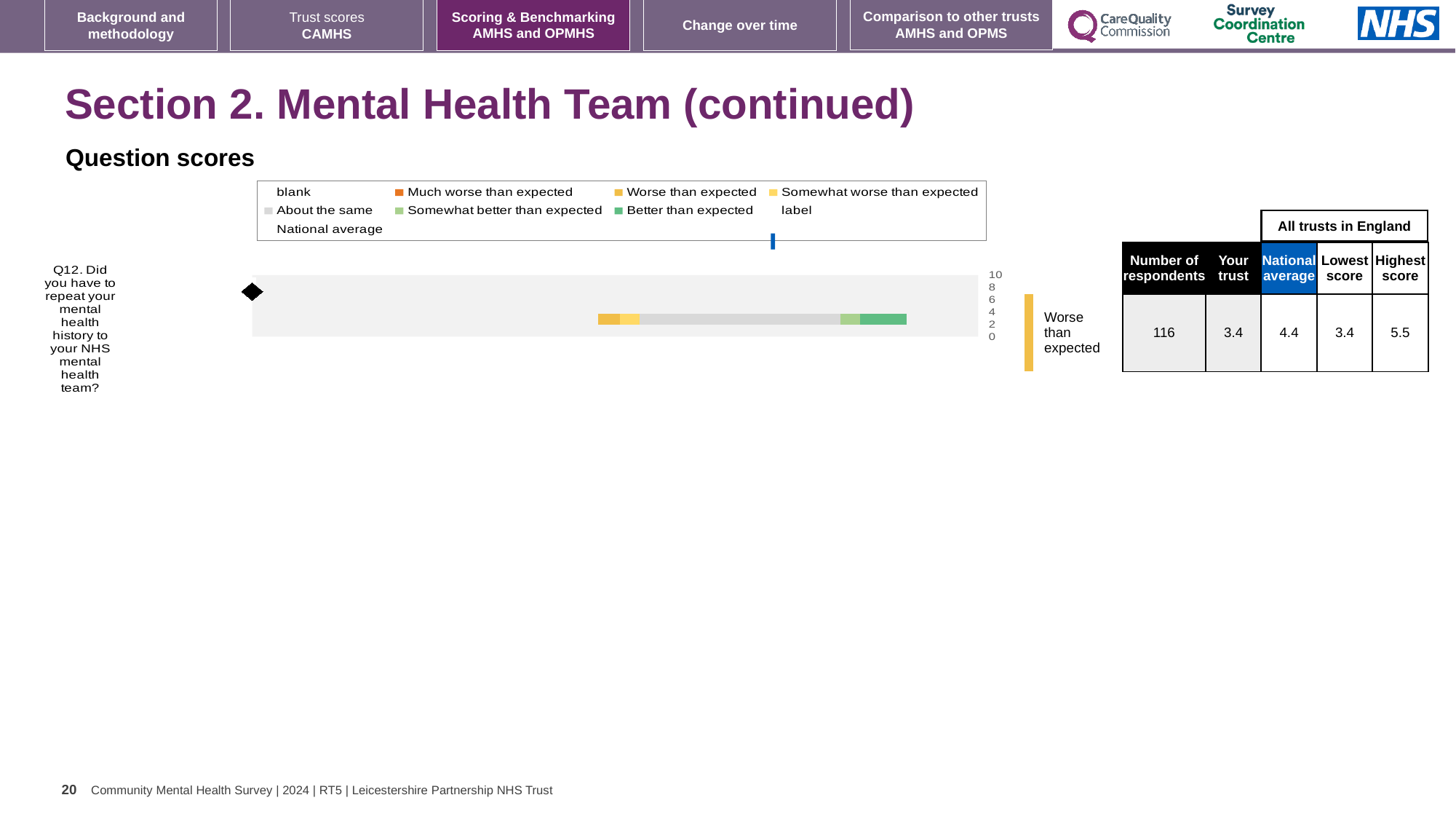
In the table next to the chart, what is the national average score for Q12? 4.4 Which question is plotted in the chart? Q12. Did you have to repeat your mental health history to your NHS mental health team? In the table next to the chart, what is the 'Your trust' score for Q12? 3.4 In the table next to the chart, what is the difference between the highest score and the lowest score for Q12? 2.1 In the table next to the chart, what is the highest score among all trusts in England for Q12? 5.5 In the table next to the chart, what is the lowest score among all trusts in England for Q12? 3.4 How many questions (categories) are plotted in the chart? 1 What benchmark label is shown to the right of the chart for Q12? Worse than expected In the table next to the chart, what is the difference between the national average and the 'Your trust' score for Q12? 1.0 In the table next to the chart, what is the number of respondents for Q12? 116 In the table next to the chart, which is larger for Q12: the 'Your trust' score or the national average? National average What kind of chart is shown under 'Question scores'? bar chart